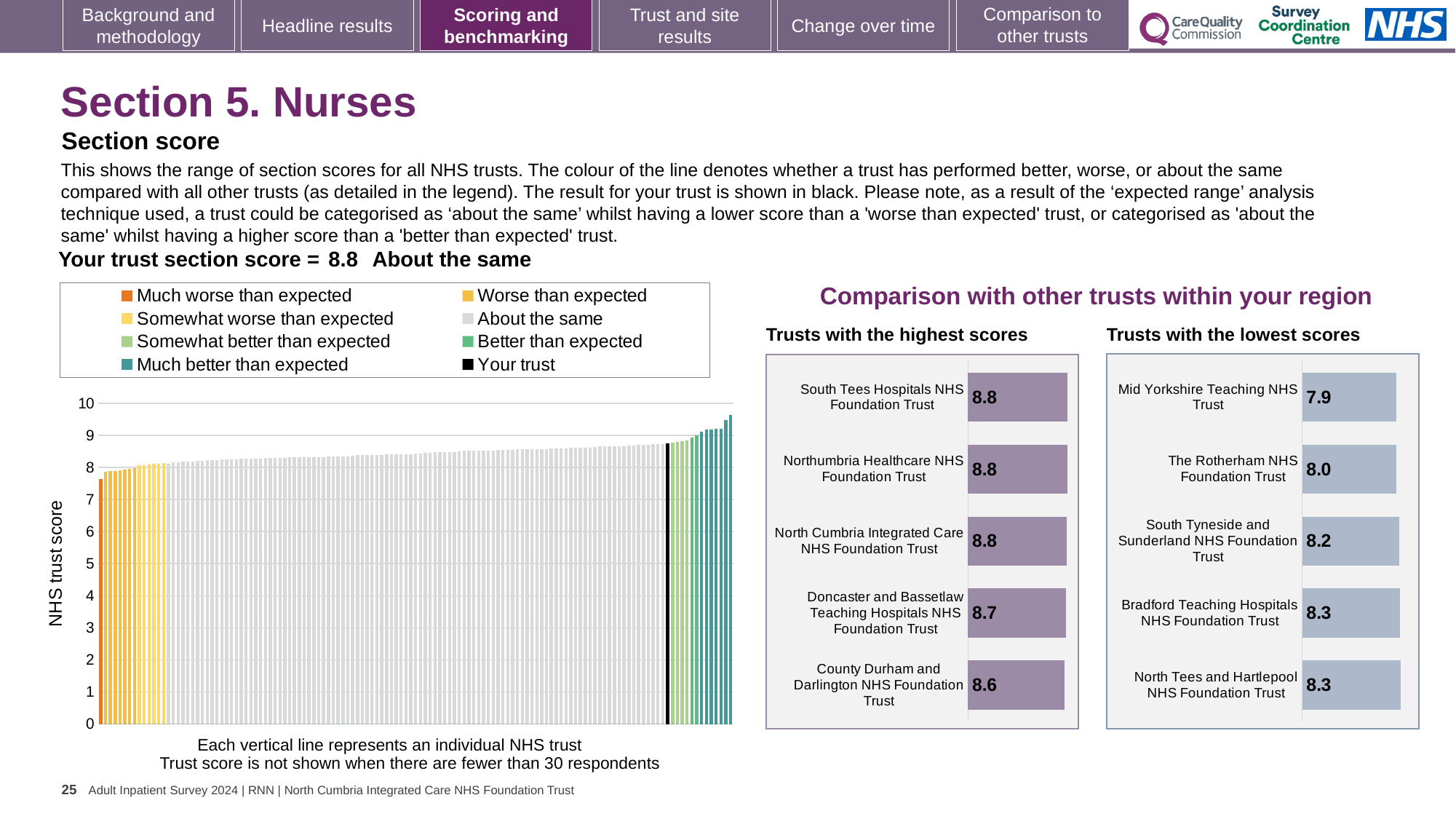
In the 'Trusts with the lowest scores' chart, which trust has the lowest score? Mid Yorkshire Teaching NHS Trust How many entries does the legend of the main section score chart on the left list? 8 In the 'Trusts with the highest scores' chart, what is the score for County Durham and Darlington NHS Foundation Trust? 8.6 In the 'Trusts with the lowest scores' chart, what is the score for The Rotherham NHS Foundation Trust? 8.0 In the 'Trusts with the highest scores' chart, which trust has the lowest score? County Durham and Darlington NHS Foundation Trust In the 'Trusts with the lowest scores' chart, what is the difference between the scores of South Tyneside and Sunderland NHS Foundation Trust and Mid Yorkshire Teaching NHS Trust? 0.3 In the 'Trusts with the highest scores' chart, what is the score for Doncaster and Bassetlaw Teaching Hospitals NHS Foundation Trust? 8.7 How many trusts are shown in the 'Trusts with the lowest scores' chart? 5 What kind of chart is the main section score chart on the left of the slide? Bar chart In the 'Trusts with the highest scores' chart, which has the larger score: Doncaster and Bassetlaw Teaching Hospitals NHS Foundation Trust or County Durham and Darlington NHS Foundation Trust? Doncaster and Bassetlaw Teaching Hospitals NHS Foundation Trust In the main section score chart on the left, is the value of the leftmost bar greater or less than 8? less In the main section score chart on the left, do the trust scores rise or fall from left to right? Rise